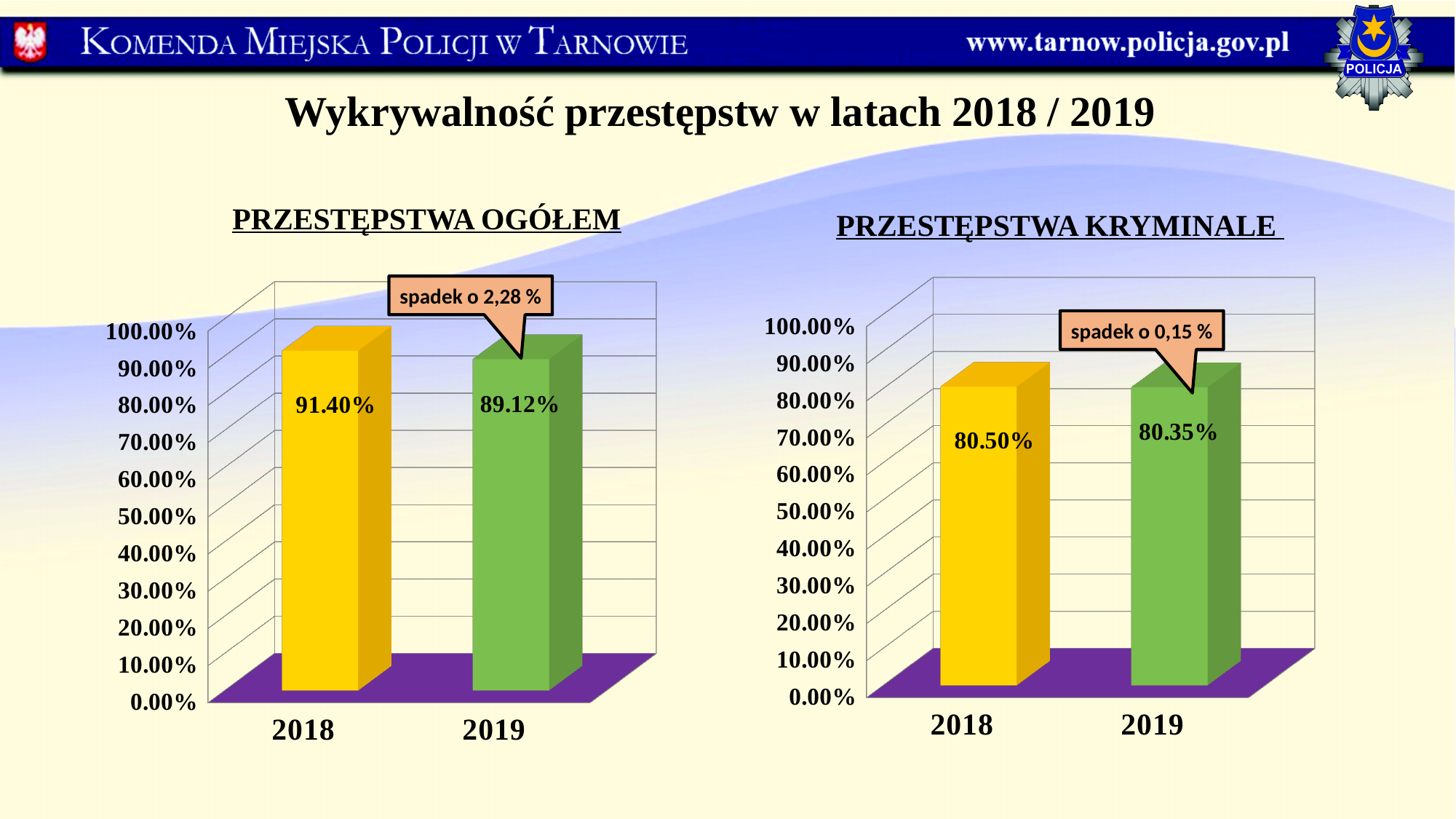
In the PRZESTĘPSTWA OGÓŁEM chart, what is the value for 2019? 89.12% In the PRZESTĘPSTWA KRYMINALE chart, is the value for 2018 greater or less than 70.00%? greater In the PRZESTĘPSTWA OGÓŁEM chart, what is the difference between the 2018 and 2019 values? 2.28% In the PRZESTĘPSTWA KRYMINALE chart, what is the value for 2019? 80.35% In the PRZESTĘPSTWA OGÓŁEM chart, do the values rise or fall from 2018 to 2019? fall In the PRZESTĘPSTWA OGÓŁEM chart, which year has the higher value? 2018 In the PRZESTĘPSTWA KRYMINALE chart, what is the value for 2018? 80.50% In the PRZESTĘPSTWA OGÓŁEM chart, is the value for 2019 greater or less than 90.00%? less In the PRZESTĘPSTWA OGÓŁEM chart, what is the value for 2018? 91.40% How many categories are shown on the x axis of the PRZESTĘPSTWA KRYMINALE chart? 2 In the PRZESTĘPSTWA KRYMINALE chart, what is the difference between the 2018 and 2019 values? 0.15% What kind of chart is the PRZESTĘPSTWA OGÓŁEM chart? bar chart